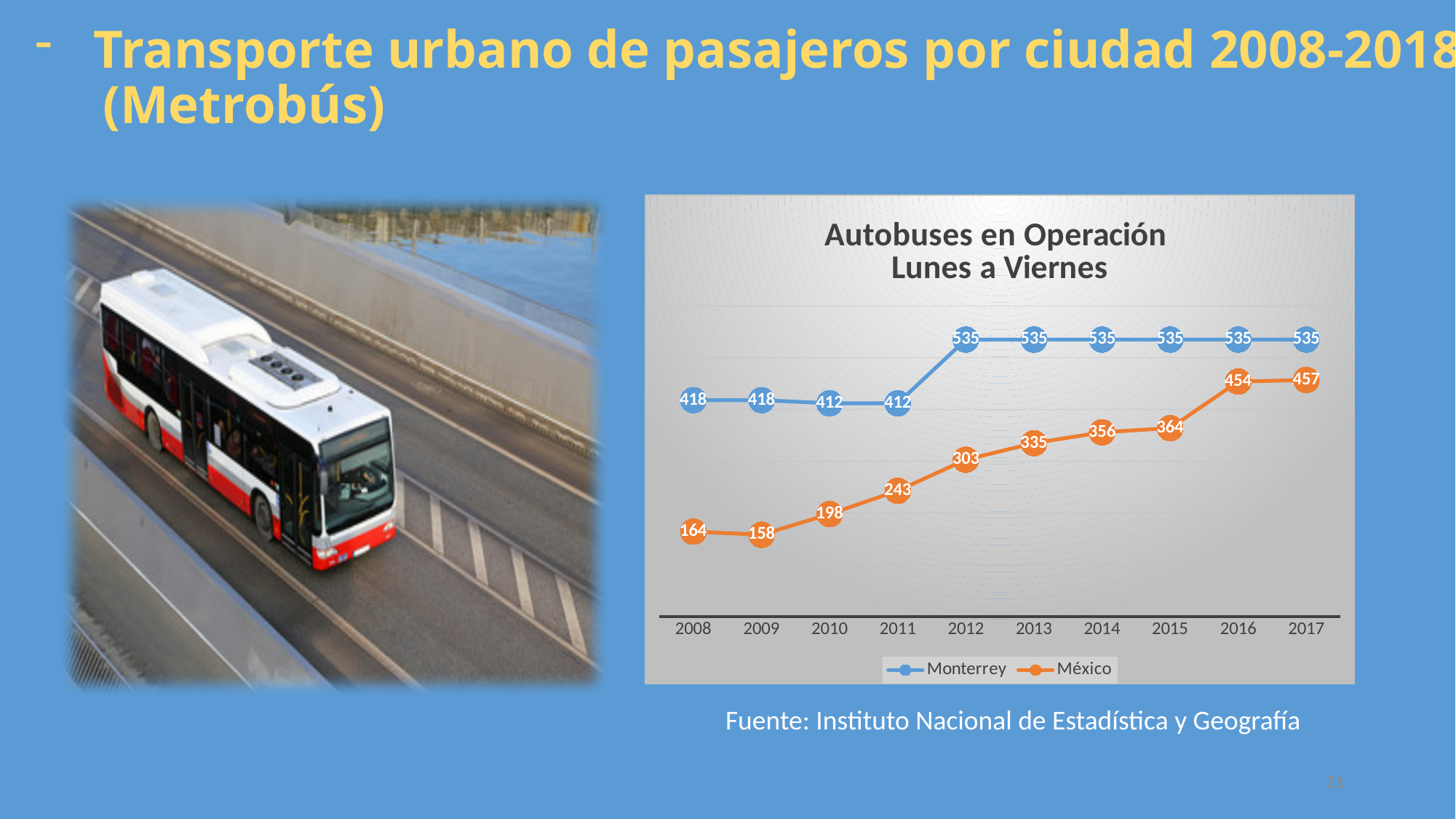
What is the value for Monterrey in 2008? 418 What kind of chart is shown? Line chart How many series does the legend list? 2 What is the difference between Monterrey and México in 2017? 78 Does the México series generally rise or fall from 2009 to 2017? Rise What is the difference between the México values in 2008 and 2017? 293 Which series has the larger value in 2011, Monterrey or México? Monterrey How many years are shown on the x axis? 10 What is the value for México in 2012? 303 What is the title of the chart? Autobuses en Operación Lunes a Viernes What is the value for México in 2017? 457 In which year is the México series lowest? 2009